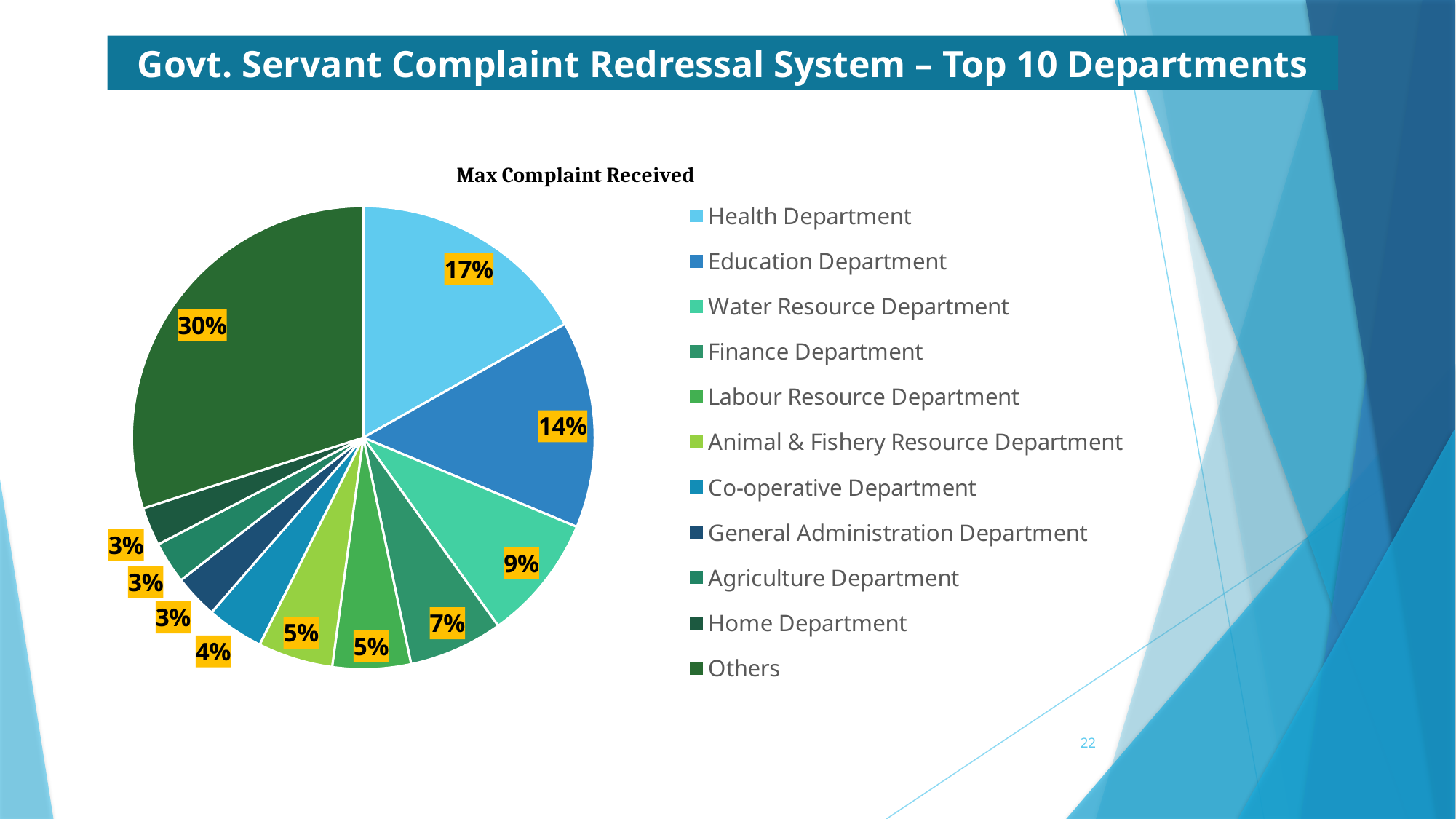
What percentage is shown for the Water Resource Department? 9% Among the named departments (excluding Others), which has the largest share? Health Department Which category has the largest slice of the pie? Others What percentage is shown for the Finance Department? 7% Which is larger, the share for the Water Resource Department or the Finance Department? Water Resource Department How many categories does the legend list? 11 What percentage is shown for the Education Department? 14% What share of complaints does the Health Department account for? 17% What share of the pie is labelled Others? 30% What is the title of the chart? Max Complaint Received What kind of chart is shown on the slide? pie chart What is the difference in percentage points between the Health Department and the Education Department? 3